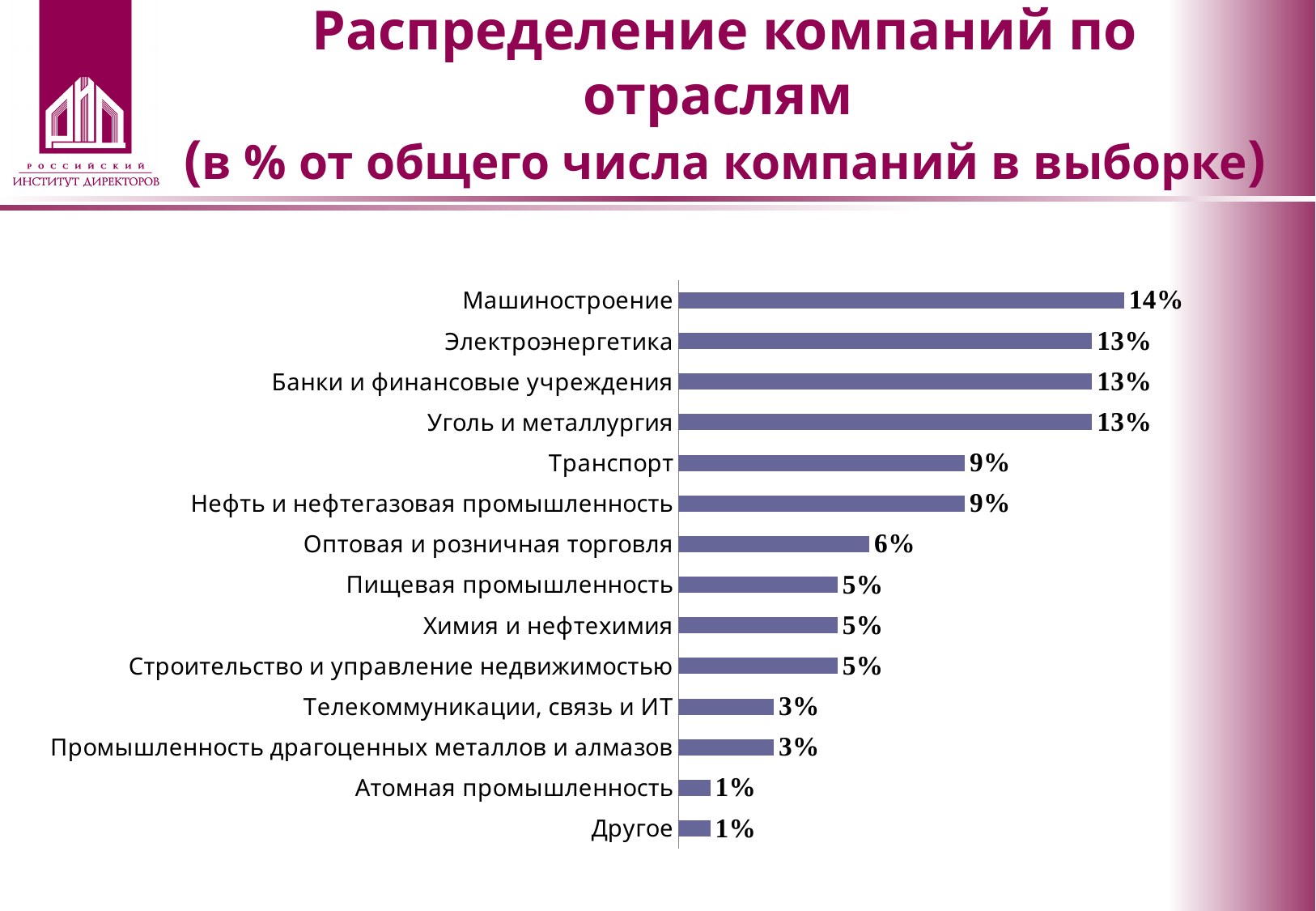
Which category has the highest value? Машиностроение What is the value for Оптовая и розничная торговля? 6% How many categories are shown in the chart? 14 Which is larger, the value for Электроэнергетика or the value for Нефть и нефтегазовая промышленность? Электроэнергетика What kind of chart is shown on the slide? Bar chart What is the value for Машиностроение? 14% What is the difference between the values for Транспорт and Пищевая промышленность? 4% Which is larger, the value for Химия и нефтехимия or the value for Атомная промышленность? Химия и нефтехимия What is the value for Атомная промышленность? 1% What is the value for Транспорт? 9% What is the value for Телекоммуникации, связь и ИТ? 3% What is the difference between the values for Машиностроение and Оптовая и розничная торговля? 8%